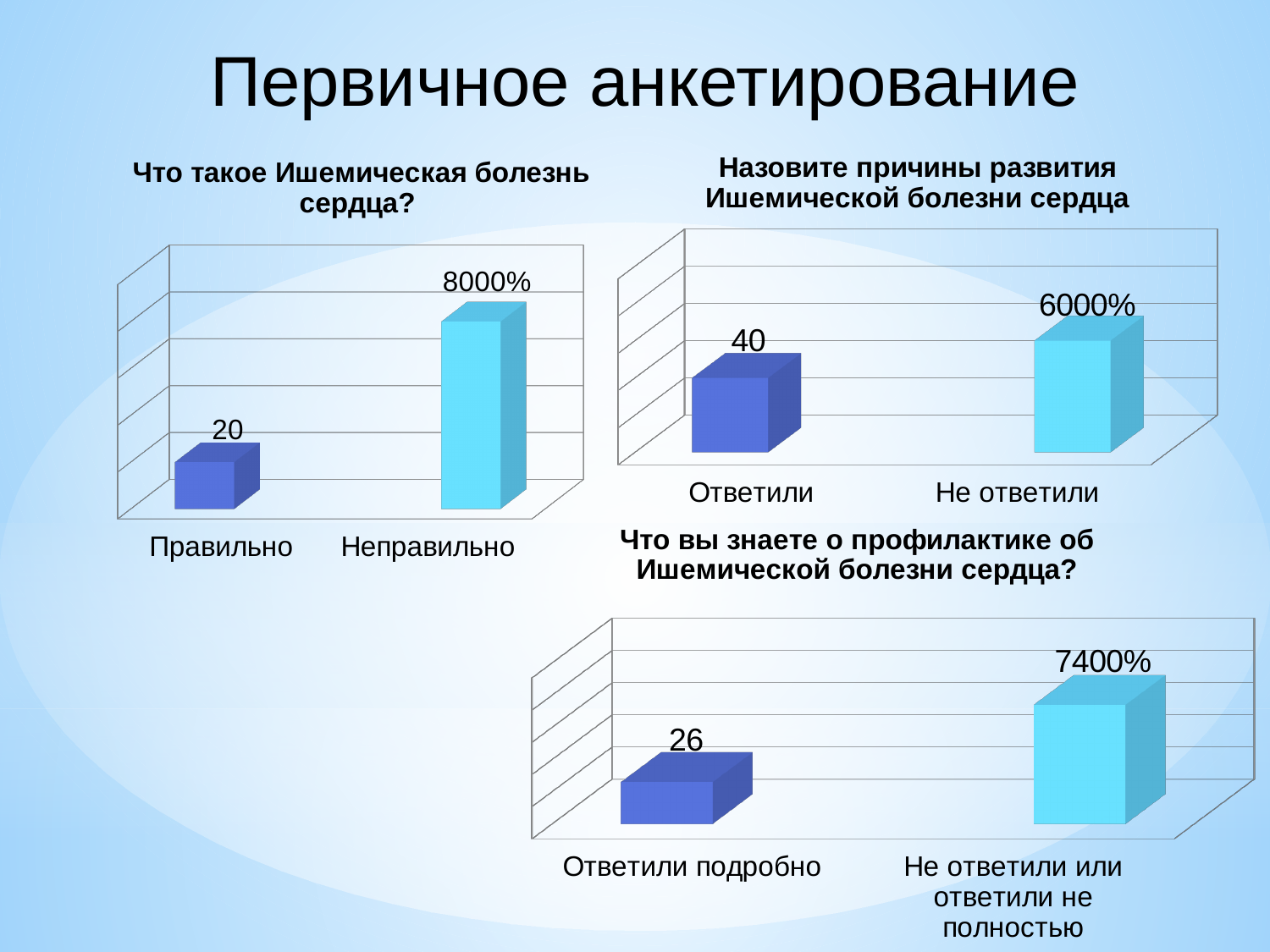
How many charts are shown on the slide? 3 In the chart titled "Что такое Ишемическая болезнь сердца?", what is the data label on the bar for Неправильно? 8000% In the chart titled "Что вы знаете о профилактике об Ишемической болезни сердца?", which bar is taller: Ответили подробно or Не ответили или ответили не полностью? Не ответили или ответили не полностью What kind of chart is the one titled "Назовите причины развития Ишемической болезни сердца"? Bar chart In the chart titled "Что вы знаете о профилактике об Ишемической болезни сердца?", what is the data label on the bar for Не ответили или ответили не полностью? 7400% How many categories are shown in the chart titled "Что вы знаете о профилактике об Ишемической болезни сердца?"? 2 In the chart titled "Назовите причины развития Ишемической болезни сердца", what is the data label on the bar for Ответили? 40 In the chart titled "Назовите причины развития Ишемической болезни сердца", which category has the shorter bar? Ответили In the chart titled "Что такое Ишемическая болезнь сердца?", what is the data label on the bar for Правильно? 20 In the chart titled "Назовите причины развития Ишемической болезни сердца", what is the data label on the bar for Не ответили? 6000% In the chart titled "Что такое Ишемическая болезнь сердца?", which category has the taller bar? Неправильно In the chart titled "Что вы знаете о профилактике об Ишемической болезни сердца?", what is the data label on the bar for Ответили подробно? 26